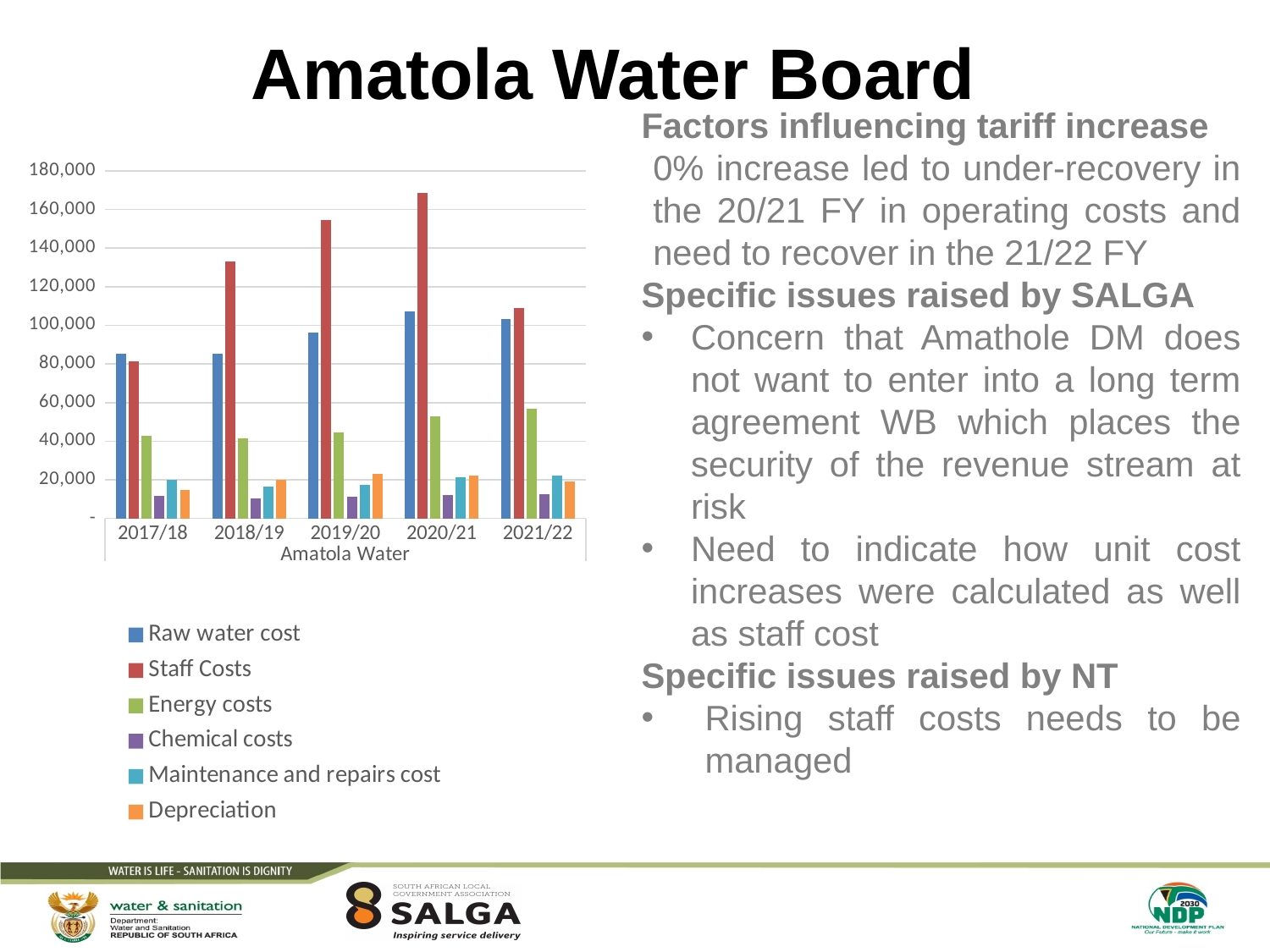
Which cost series has the lowest value in 2020/21? Chemical costs Is the value for Chemical costs in 2017/18 greater or less than 20,000? less How many financial years are shown on the x axis of the chart? 5 Is the value for Staff Costs in 2020/21 greater or less than 160,000? greater Do Staff Costs rise or fall from 2017/18 to 2020/21? Rise What kind of chart is shown on the slide? Bar chart Is the value for Energy costs in 2021/22 greater or less than 40,000? greater How many series does the chart legend list? 6 In 2018/19, which is larger: Staff Costs or Raw water cost? Staff Costs In which financial year are Staff Costs highest? 2020/21 What label appears beneath the year categories on the x axis of the chart? Amatola Water